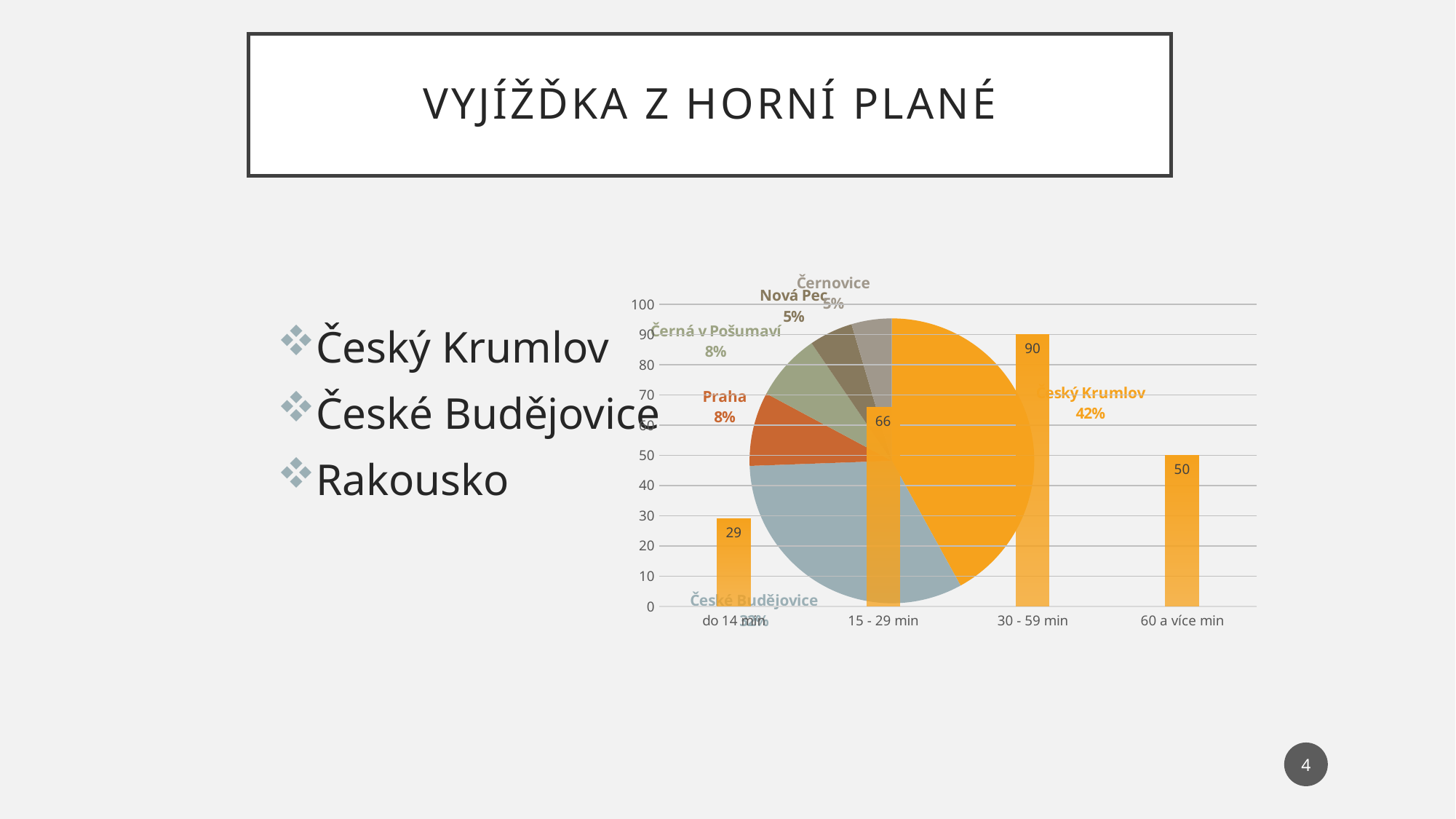
In the bar chart, which category has the lowest value? do 14 min What kind of chart is the chart with the time categories on the x axis? bar chart In the bar chart, what is the difference between the values for 30 - 59 min and 15 - 29 min? 24 In the bar chart, what is the value for 60 a více min? 50 In the pie chart, what share does Praha have? 8% In the bar chart, which is larger, the value for 15 - 29 min or the value for 60 a více min? 15 - 29 min In the bar chart, what is the value for do 14 min? 29 In the pie chart, which slice is the largest? Český Krumlov In the pie chart, what share does Český Krumlov have? 42% How many categories does the bar chart show? 4 In the bar chart, what is the value for 30 - 59 min? 90 In the bar chart, which category has the highest value? 30 - 59 min